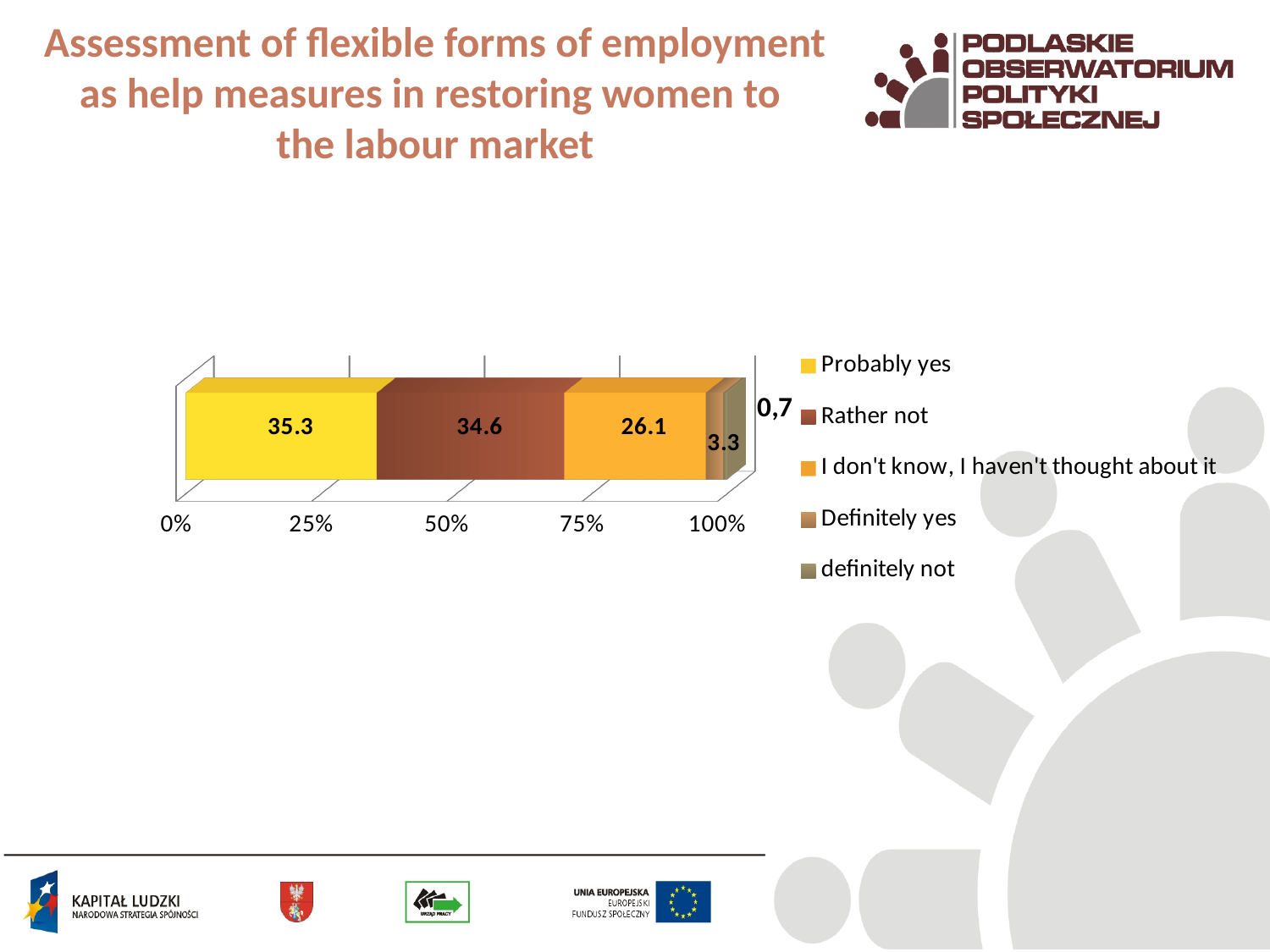
What kind of chart is shown on the slide? Stacked bar chart What is the difference between the values for "Probably yes" and "Rather not"? 0.7 Which is larger, the value for "I don't know, I haven't thought about it" or the value for "Definitely yes"? I don't know, I haven't thought about it What value is shown for "I don't know, I haven't thought about it"? 26.1 Which response category has the largest value? Probably yes How many series does the legend list? 5 Which response category has the smallest value? definitely not What value is shown for "Rather not"? 34.6 What value is shown for "Probably yes"? 35.3 What value is shown for "definitely not"? 0,7 What colour is used for the "Rather not" segment? Brown What value is shown for "Definitely yes"? 3.3